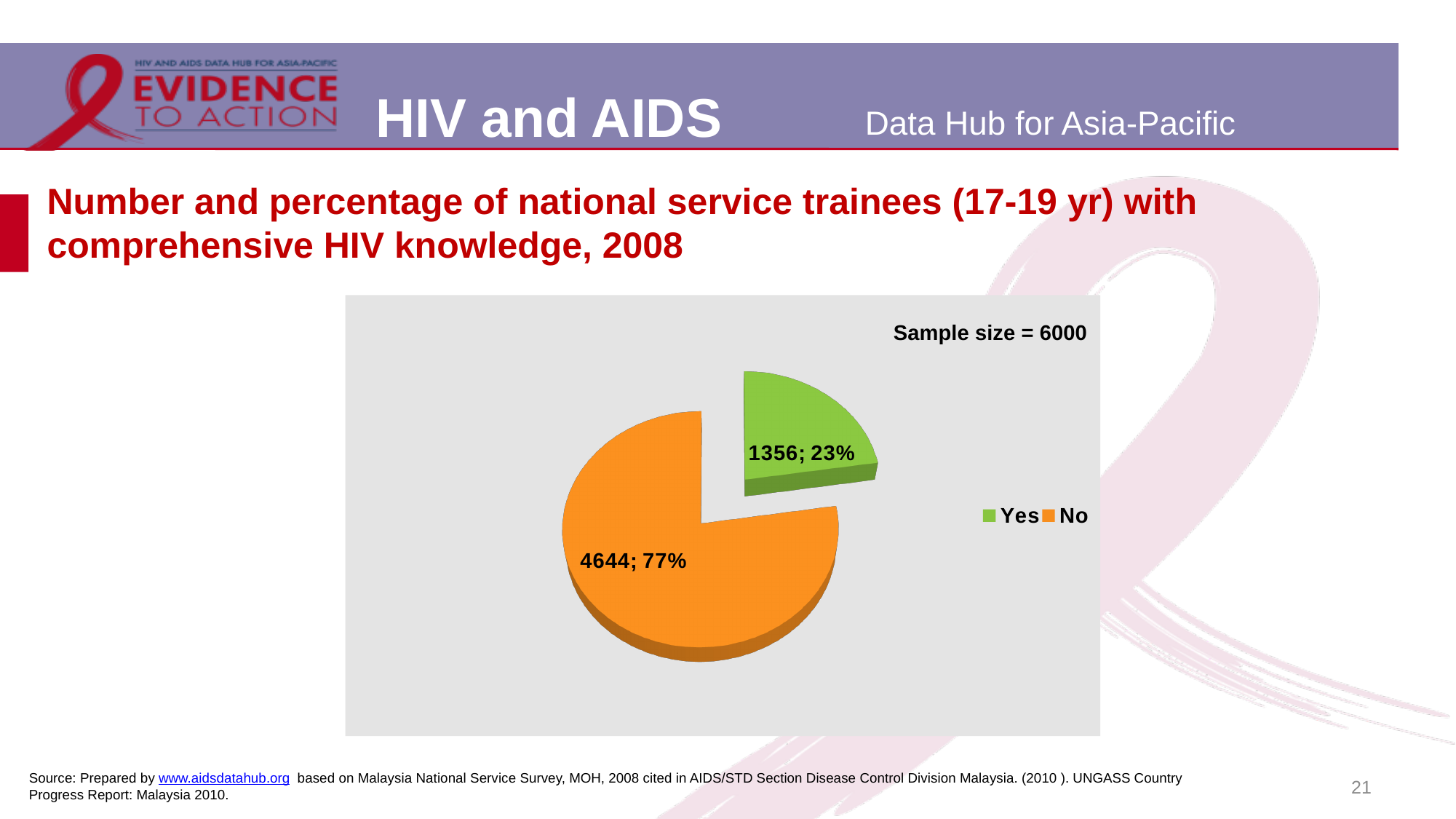
How many trainees answered Yes to having comprehensive HIV knowledge? 1356 Which category has the smallest slice of the pie? Yes How many slices does the pie chart have? 2 How many trainees answered No? 4644 What percentage of trainees is represented by the No slice? 77% What sample size is stated on the chart? 6000 What kind of chart is shown on the slide? pie chart Which category has the larger slice, Yes or No? No What colour is the Yes slice? green What percentage of trainees is represented by the Yes slice? 23% How many entries does the legend list? 2 What is the difference between the number of No and Yes responses? 3288